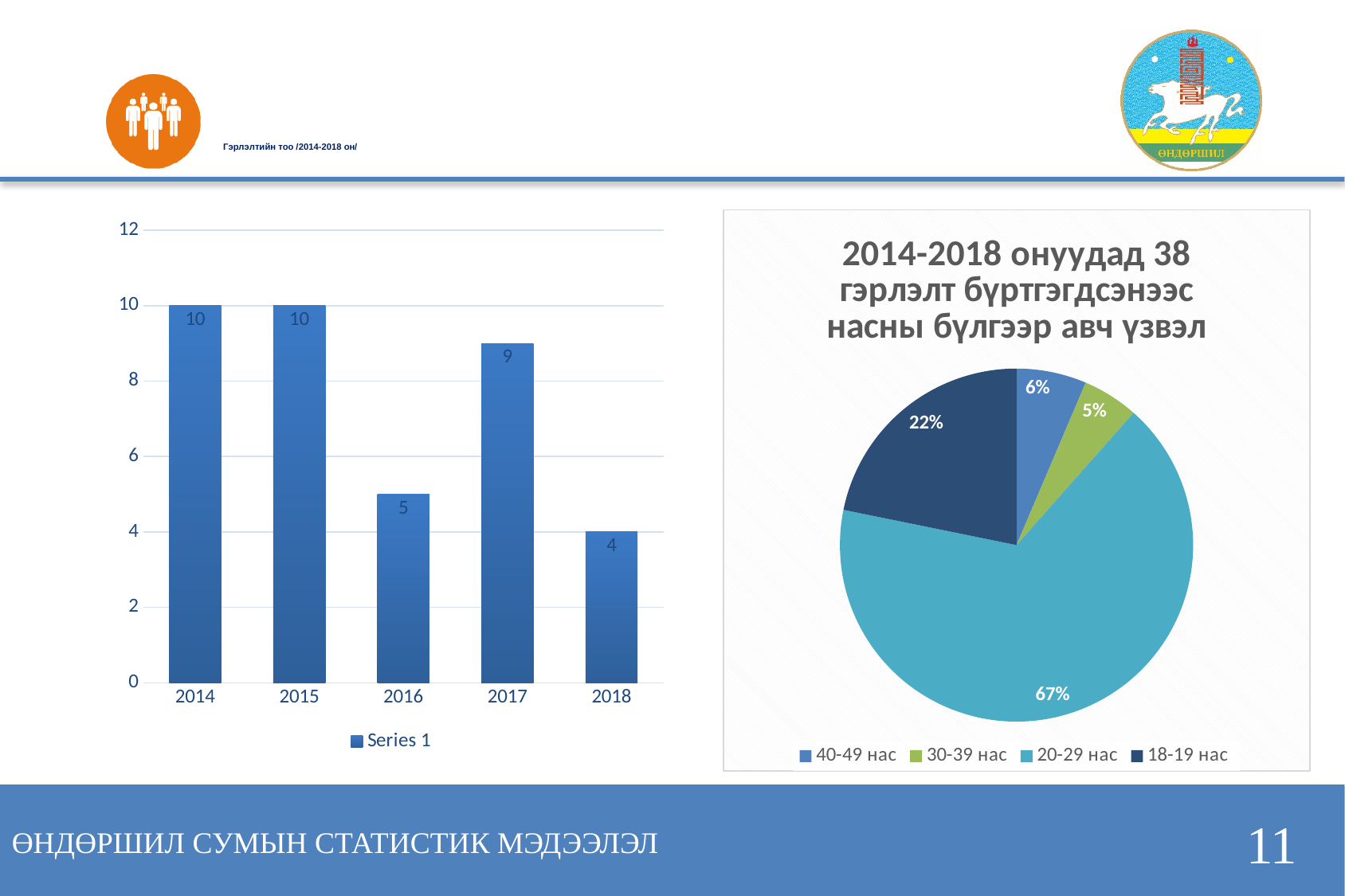
In the bar chart on the left, which is larger, the value for 2016 or the value for 2017? 2017 In the pie chart on the right, which age group has the smallest slice? 30-39 нас In the bar chart on the left, what is the difference between the values for 2015 and 2016? 5 What kind of chart is the chart on the left? bar chart In the pie chart on the right, what share does the 20-29 нас slice have? 67% In the bar chart on the left, how many years are shown on the x axis? 5 How many categories does the legend of the pie chart on the right list? 4 In the bar chart on the left, which year has the lowest value? 2018 In the bar chart on the left, what is the value for 2018? 4 In the pie chart on the right, what share does the 18-19 нас slice have? 22% In the bar chart on the left, what is the value for 2017? 9 In the bar chart on the left, what is the name of the series shown in the legend? Series 1